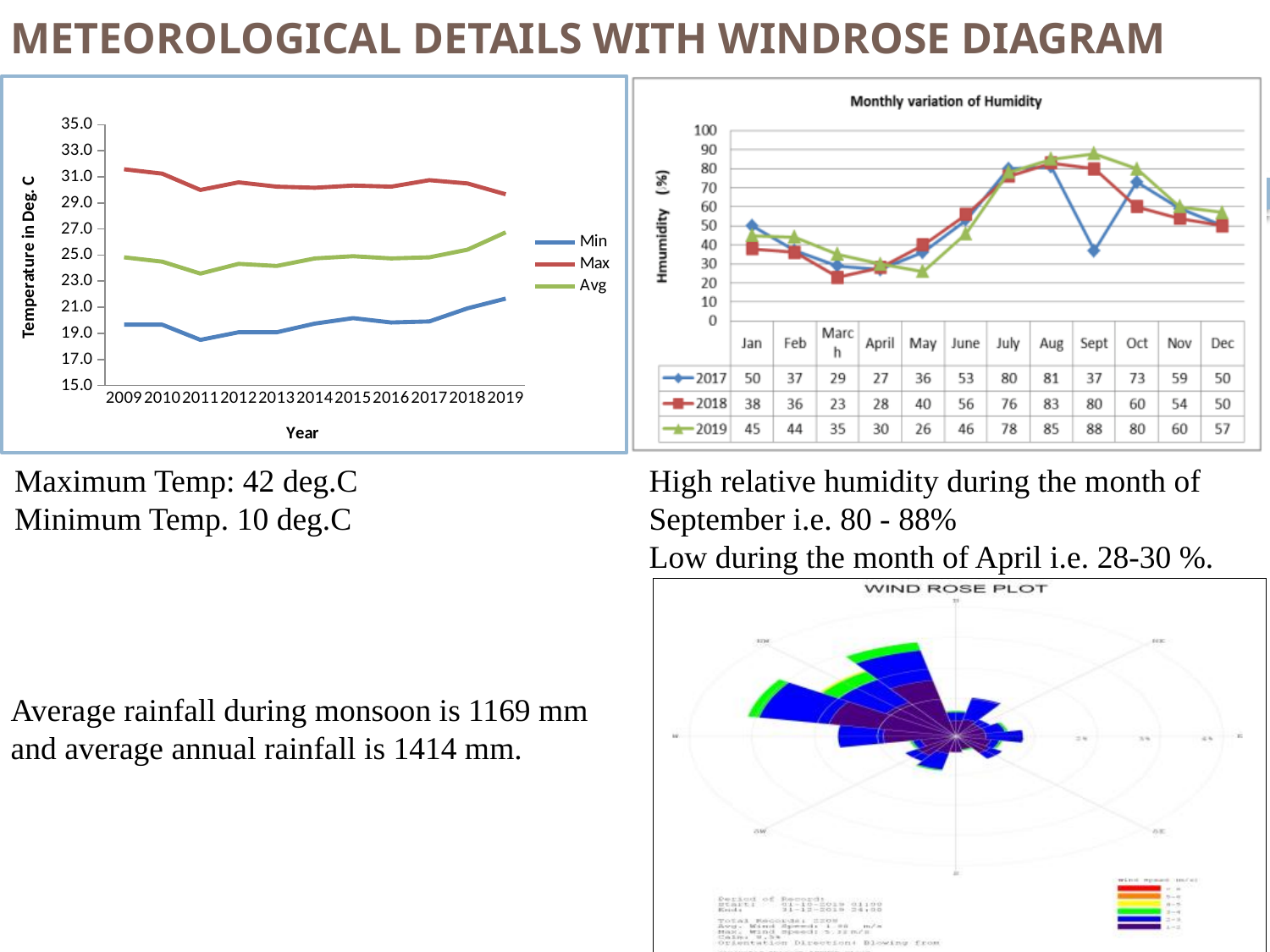
In the 'Monthly variation of Humidity' chart, which is larger for October: the 2017 value or the 2018 value? 2017 How many months are plotted along the x axis of the 'Monthly variation of Humidity' chart? 12 In the 'Monthly variation of Humidity' chart, which month has the lowest humidity value for the 2019 series? May In the 'Monthly variation of Humidity' chart, what is the humidity value for March in 2018? 23 In the temperature chart on the left, is the Min value for 2011 greater or less than 19.0? less How many series does the legend of the temperature chart on the left list? 3 What kind of chart is the temperature chart on the left of the slide? Line chart In the temperature chart on the left, is the Max value for 2009 greater or less than 31.0? greater In the 'Monthly variation of Humidity' chart, what is the humidity value for September in 2019? 88 How many series does the legend of the 'Monthly variation of Humidity' chart list? 3 In the 'Monthly variation of Humidity' chart, what is the difference between the 2019 and 2017 values for September? 51 In the 'Monthly variation of Humidity' chart, which month has the highest humidity value for the 2017 series? Aug